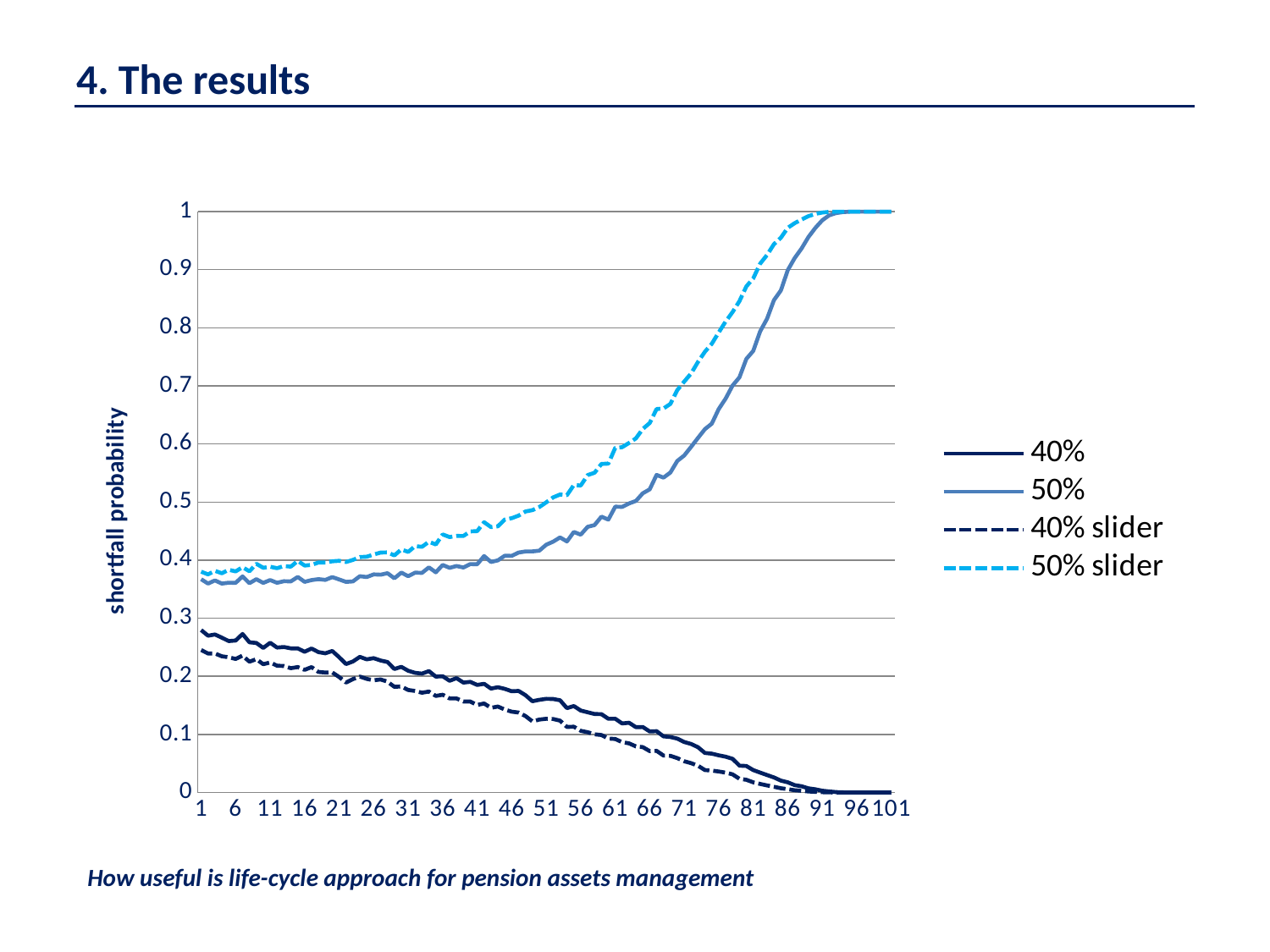
What kind of chart is shown on the slide? line chart Which two series are drawn with dashed lines? 40% slider and 50% slider What value does the 50% slider series reach at x = 101? 1 Is the value of the 50% series at x = 81 greater or less than 0.7? greater How many series does the legend list? 4 Does the 50% series rise or fall as the x axis increases? rise Is the value of the 50% series at x = 1 greater or less than 0.4? less At x = 61, which series has the higher value: 50% or 50% slider? 50% slider Is the value of the 40% slider series at x = 1 greater or less than 0.2? greater What is the label of the vertical axis? shortfall probability What value does the 40% series reach at x = 101? 0 Does the 40% series rise or fall as the x axis increases? fall